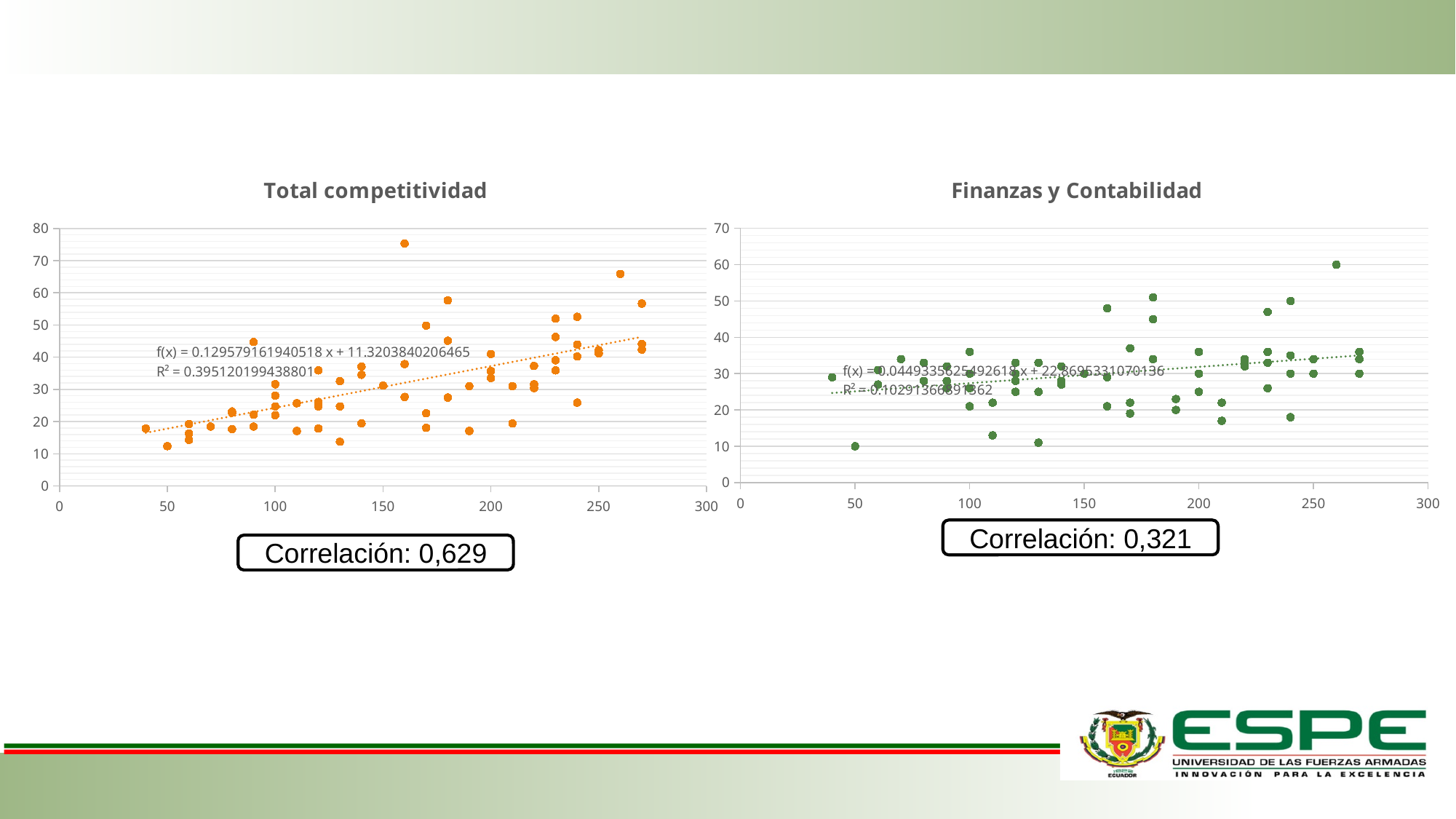
In the "Total competitividad" chart, does the dotted trend line rise or fall as x increases? Rises What R² value is printed on the "Total competitividad" chart? 0.395120199438801 In the "Total competitividad" chart, is the highest plotted point greater or less than 70? greater In the "Finanzas y Contabilidad" chart, is the highest plotted point greater or less than 50? greater What correlation value is shown below the "Finanzas y Contabilidad" chart? 0,321 Which chart shows the higher correlation value, "Total competitividad" or "Finanzas y Contabilidad"? Total competitividad What kind of chart is the "Total competitividad" chart? Scatter chart In the "Finanzas y Contabilidad" chart, does the dotted trend line rise or fall as x increases? Rises What is the difference between the correlation values shown for "Total competitividad" and "Finanzas y Contabilidad"? 0,308 What correlation value is shown below the "Total competitividad" chart? 0,629 In the "Finanzas y Contabilidad" chart, is the lowest plotted point greater or less than 20? less What kind of chart is the "Finanzas y Contabilidad" chart? Scatter chart